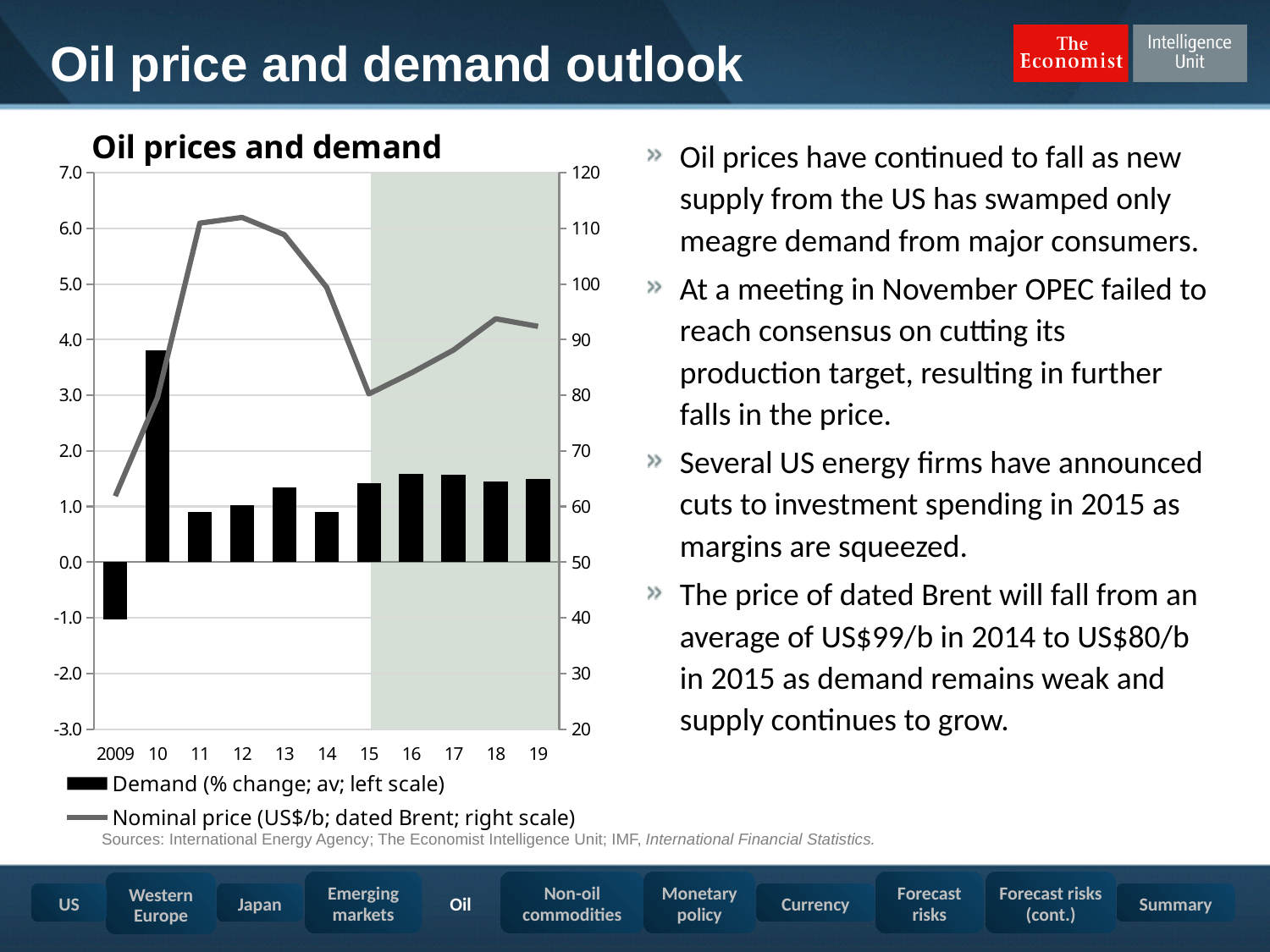
Does the nominal price line rise or fall between 2012 and 2015? Fall Which year has the higher nominal price, 2012 or 2015? 2012 How many years are shown on the x axis of the 'Oil prices and demand' chart? 11 In which year is the demand bar highest in the 'Oil prices and demand' chart? 2010 Which series is plotted on the right scale of the 'Oil prices and demand' chart? Nominal price (US$/b; dated Brent; right scale) Is the nominal price value for 2011 greater or less than 100? greater Is the demand value for 2010 greater or less than 3.0? greater In which year is the demand bar lowest in the 'Oil prices and demand' chart? 2009 In which year is the nominal price line lowest in the 'Oil prices and demand' chart? 2009 How many series does the legend of the 'Oil prices and demand' chart list? 2 Is the nominal price value for 2015 greater or less than 90? less What kind of chart is 'Oil prices and demand'? A combined bar and line chart